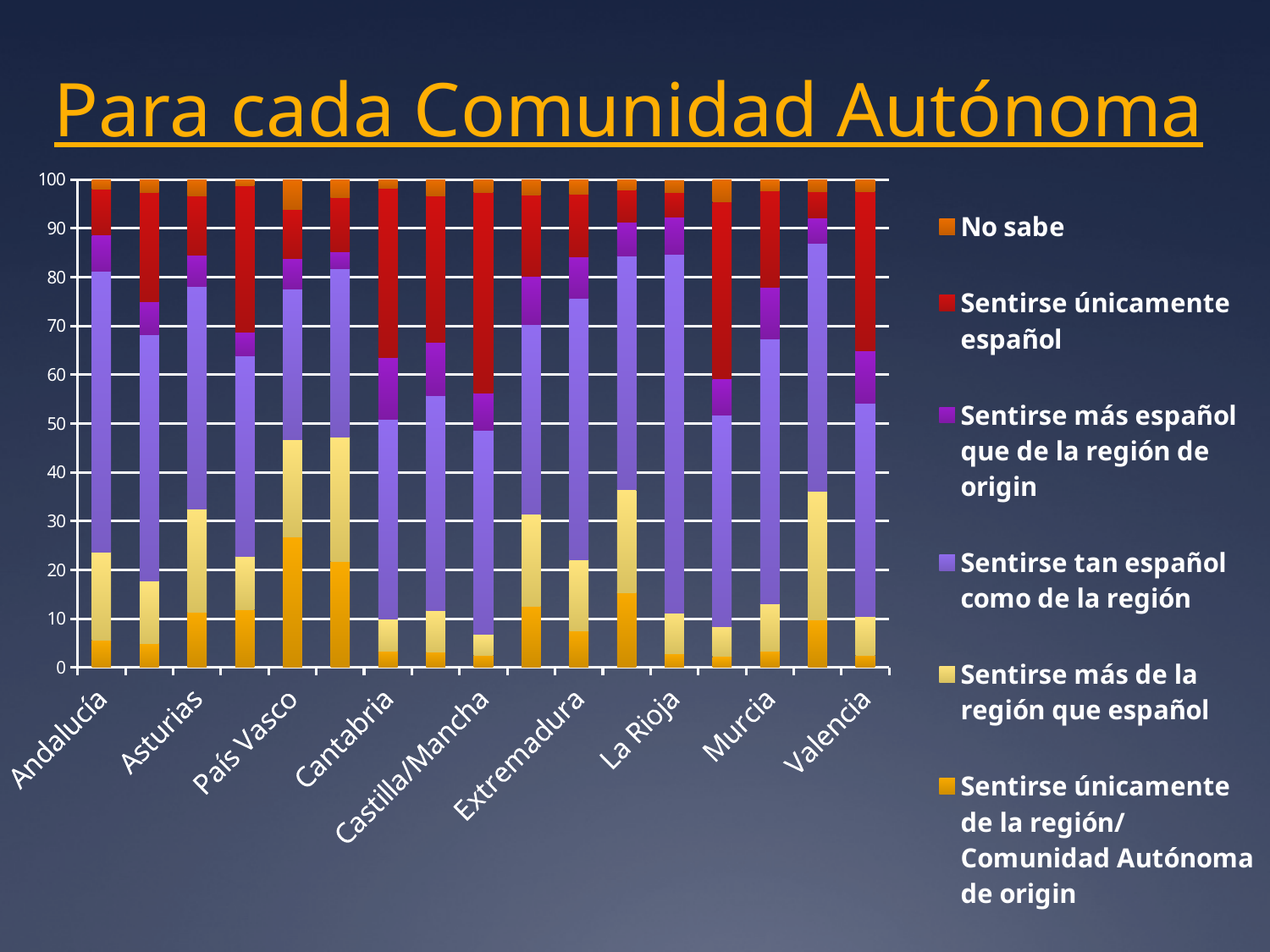
What kind of chart is shown on the slide? stacked bar chart What is the title of the slide? Para cada Comunidad Autónoma Which is larger for 'Sentirse únicamente de la región/Comunidad Autónoma de origin': País Vasco or Cantabria? País Vasco Is the 'Sentirse únicamente de la región/Comunidad Autónoma de origin' value for Andalucía greater or less than 10? less Which region has the largest 'Sentirse únicamente de la región/Comunidad Autónoma de origin' value? País Vasco Is the 'Sentirse únicamente de la región/Comunidad Autónoma de origin' value for Cantabria greater or less than 10? less Is the 'Sentirse únicamente español' value for Castilla/Mancha greater or less than 30? greater Which is larger for 'Sentirse únicamente español': Castilla/Mancha or Andalucía? Castilla/Mancha How many series does the legend list? 6 Which legend entry is shown in red? Sentirse únicamente español